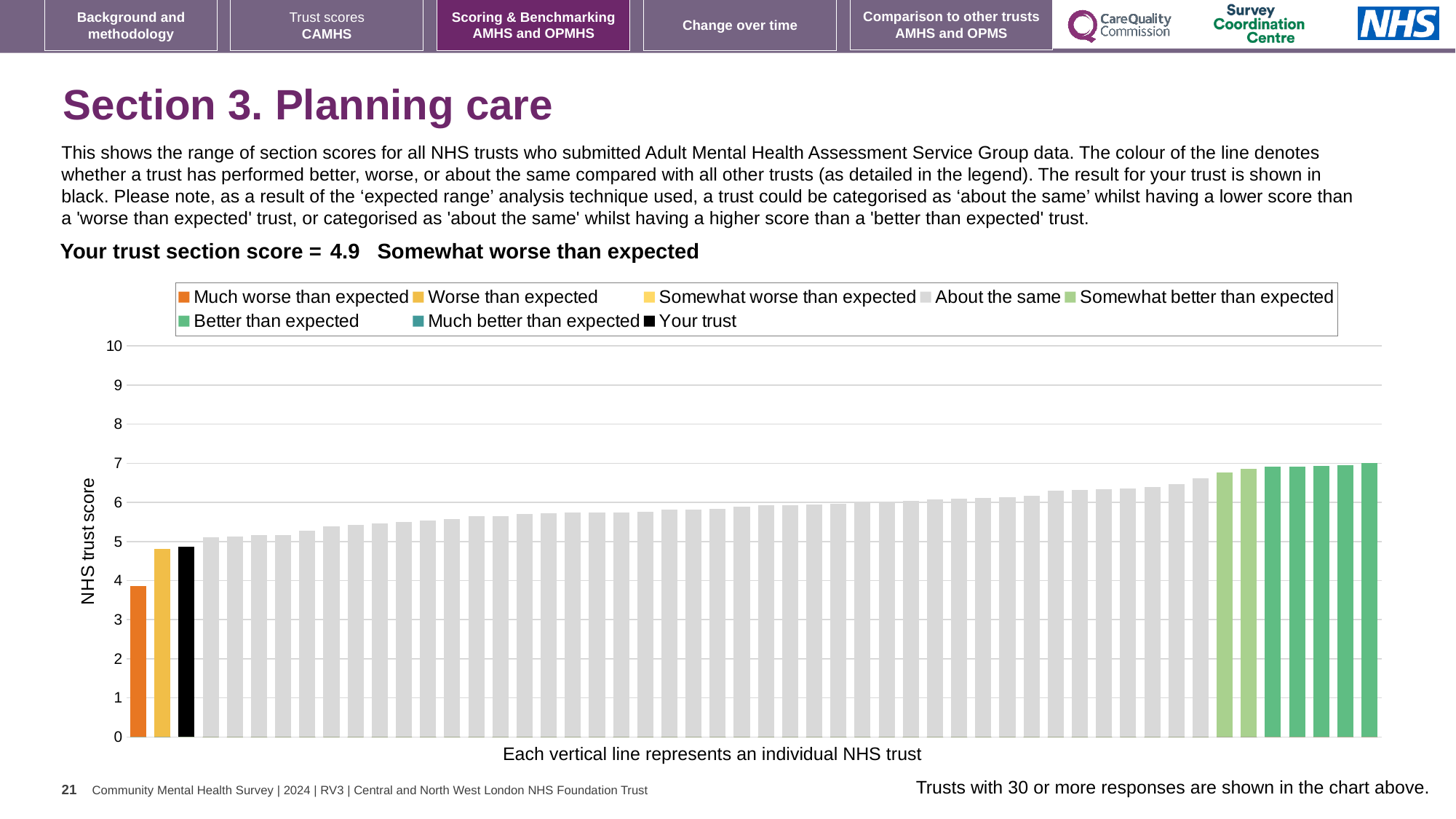
Is the value of the leftmost (orange) bar greater or less than 5? less How is your trust's score categorised on the slide? Somewhat worse than expected What kind of chart is shown on the slide? bar chart What colour is used for the 'Your trust' bar in the chart? black Is the value of the rightmost bar greater or less than 6? greater Do the bar values rise or fall from left to right along the x axis? rise Is the value of the black 'Your trust' bar greater or less than 6? less How many bars are coloured as 'Much worse than expected' (orange)? 1 What is the section score for your trust shown on the slide? 4.9 How many bars are coloured as 'Better than expected' (dark green)? 5 What is the label on the vertical axis of the chart? NHS trust score How many entries does the chart legend list? 8